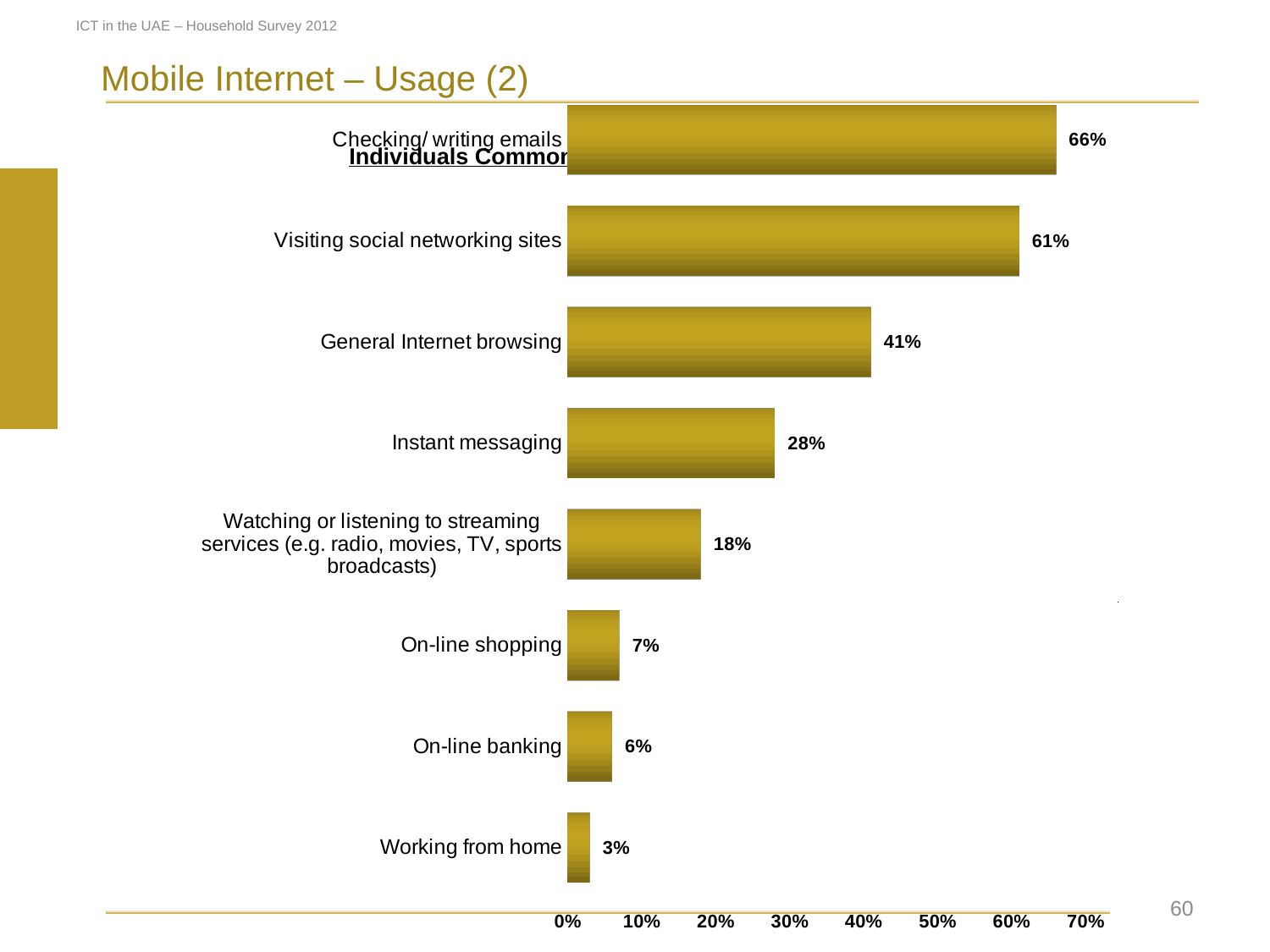
Which category has the highest value? Checking/ writing emails Which is larger, On-line shopping or On-line banking? On-line shopping What is the value for Instant messaging? 28% What is the value for Watching or listening to streaming services? 18% What is the difference between General Internet browsing and Instant messaging? 13% Which category has the lowest value? Working from home How many categories are shown in the chart? 8 What kind of chart is shown on the slide? Bar chart What is the value for On-line banking? 6% What is the highest value shown on the x axis? 70% What is the value for Visiting social networking sites? 61% What is the difference between Checking/ writing emails and Visiting social networking sites? 5%